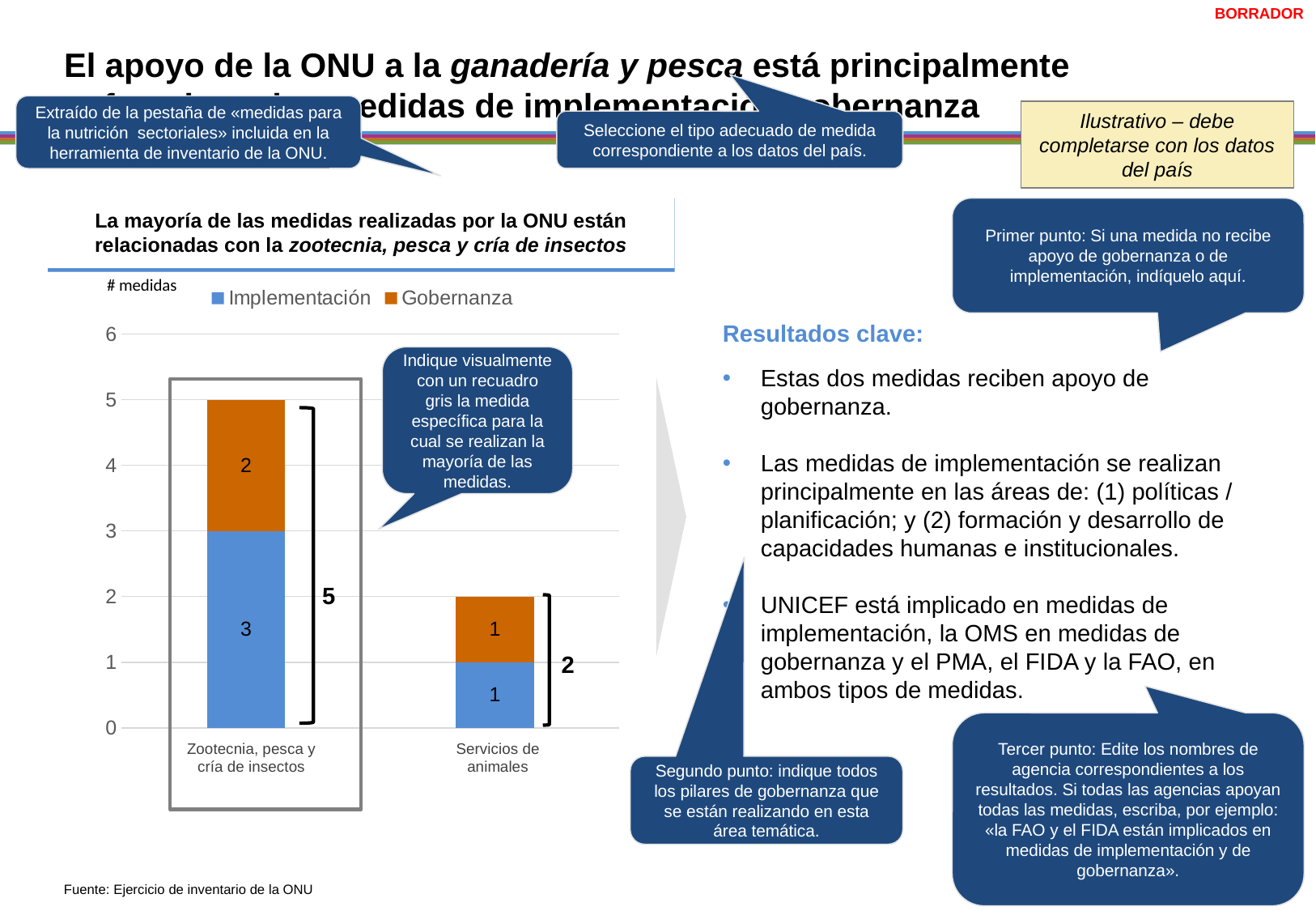
Which category has the highest total number of measures? Zootecnia, pesca y cría de insectos What is the Implementación value for Servicios de animales? 1 What is the difference between the Implementación values for Zootecnia, pesca y cría de insectos and Servicios de animales? 2 What is the Gobernanza value for Servicios de animales? 1 Which series is shown in orange in the chart legend? Gobernanza How many series does the chart legend list? 2 What is the Implementación value for Zootecnia, pesca y cría de insectos? 3 What is the total number of measures for Zootecnia, pesca y cría de insectos? 5 How many categories are shown on the x axis of the chart? 2 What type of chart is shown on the slide? Stacked bar chart What is the total number of measures for Servicios de animales? 2 What is the Gobernanza value for Zootecnia, pesca y cría de insectos? 2